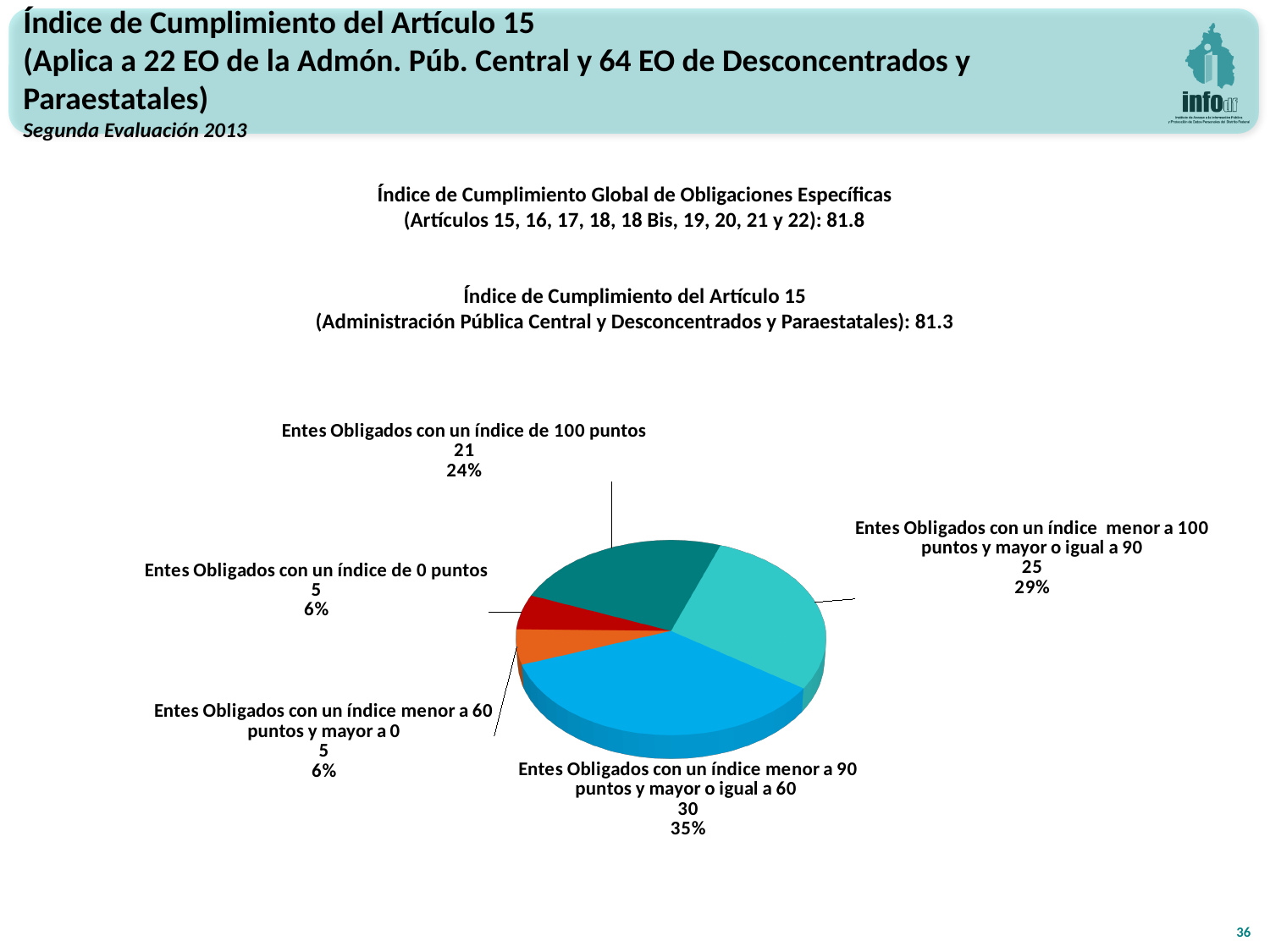
What share of the pie is Entes Obligados con un índice menor a 90 puntos y mayor o igual a 60? 35% What is the difference in count between Entes Obligados con un índice menor a 90 puntos y mayor o igual a 60 and Entes Obligados con un índice de 100 puntos? 9 Which category has the largest slice of the pie? Entes Obligados con un índice menor a 90 puntos y mayor o igual a 60 How many Entes Obligados have an índice menor a 100 puntos y mayor o igual a 90? 25 What percentage of the pie corresponds to Entes Obligados con un índice de 100 puntos? 24% What kind of chart is shown on the slide? Pie chart How many Entes Obligados have an índice de 0 puntos? 5 What is the Índice de Cumplimiento del Artículo 15 value stated above the chart? 81.3 What is the total number of Entes Obligados across all slices of the pie chart? 86 Which is larger: the count for Entes Obligados con un índice de 100 puntos or the count for Entes Obligados con un índice menor a 100 puntos y mayor o igual a 90? Entes Obligados con un índice menor a 100 puntos y mayor o igual a 90 How many Entes Obligados have an índice de 100 puntos? 21 How many slices does the pie chart have? 5